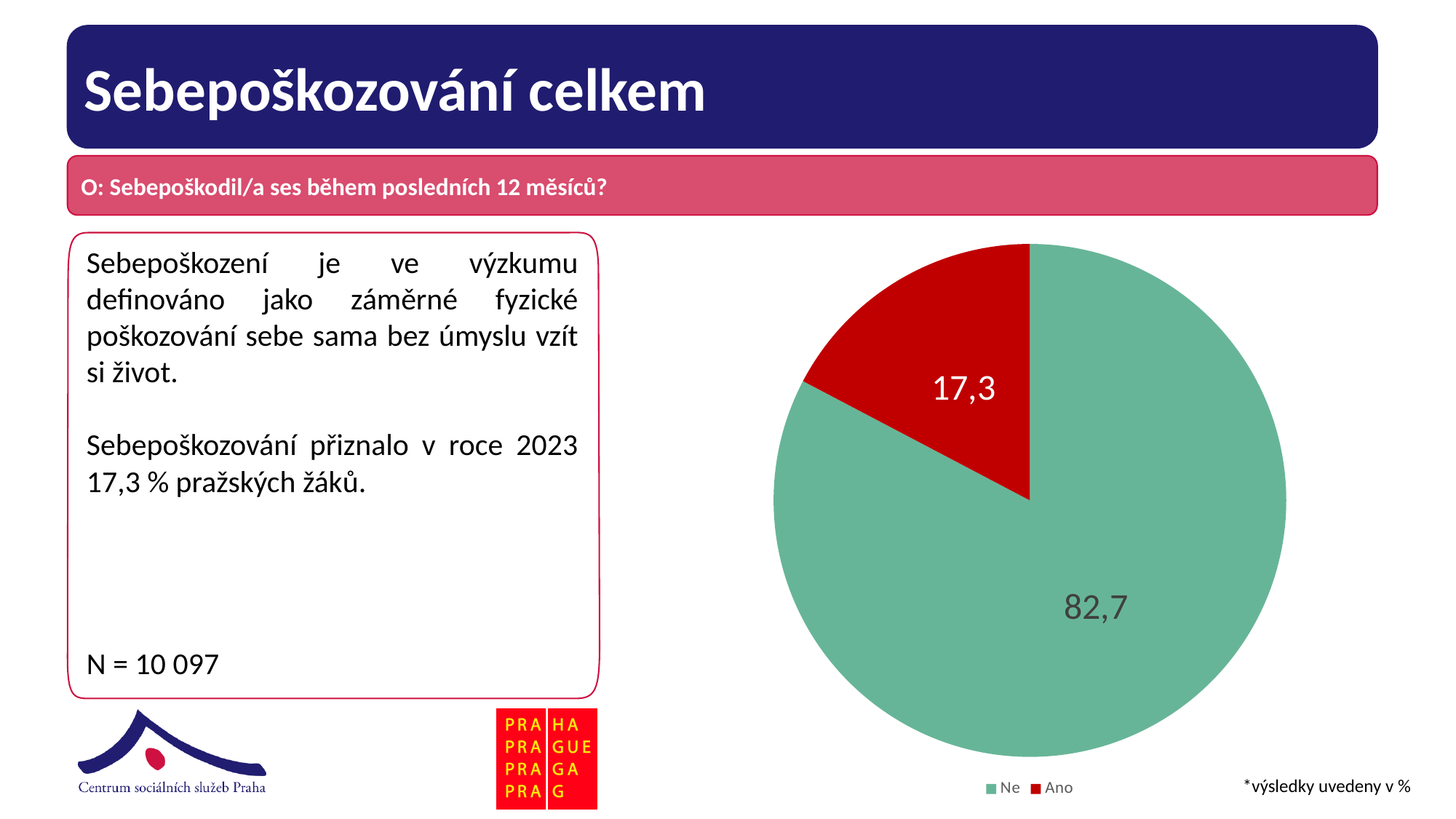
How many slices does the pie chart have? 2 What share of the pie does the "Ano" slice represent? 17,3 Which slice is the largest? Ne What colour is the "Ano" slice? red What is the difference between the "Ne" and "Ano" values? 65,4 Which slice is the smallest? Ano What is the value for the "Ne" slice? 82,7 How many entries does the legend list? 2 What is the value for the "Ano" slice? 17,3 Which is larger, the "Ne" slice or the "Ano" slice? Ne What colour is the "Ne" slice? green What kind of chart is shown on the slide? pie chart